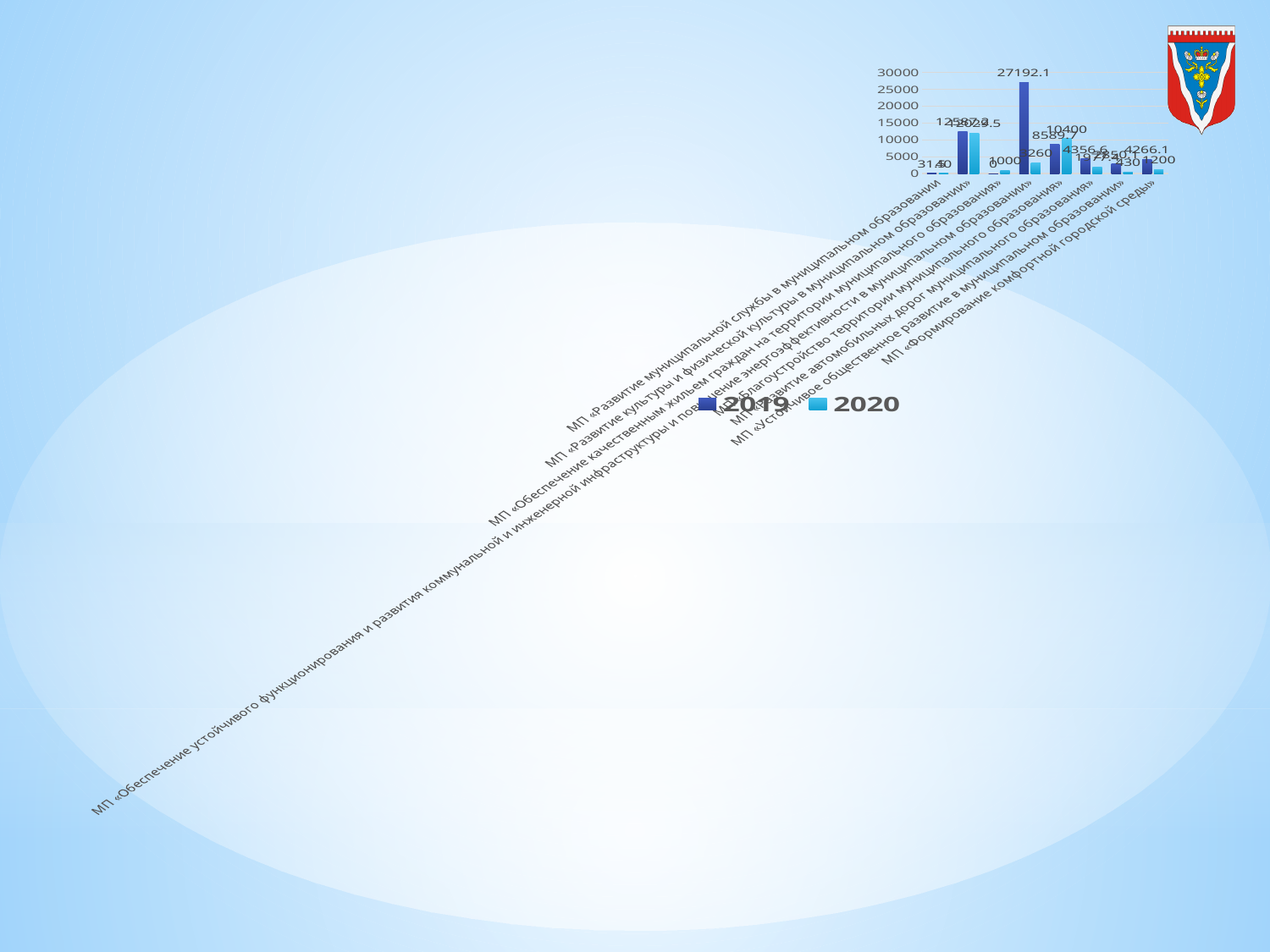
Which series is drawn in the lighter blue colour? 2020 What is the largest data label value shown on the chart? 27192.1 Is the tallest bar on the chart greater or less than 25000? greater What is the highest tick value shown on the vertical axis? 30000 Which years are listed in the chart legend? 2019 and 2020 What kind of chart is shown on the slide? bar chart How many series does the chart legend list? 2 How many categories (municipal programmes) are plotted on the chart? 8